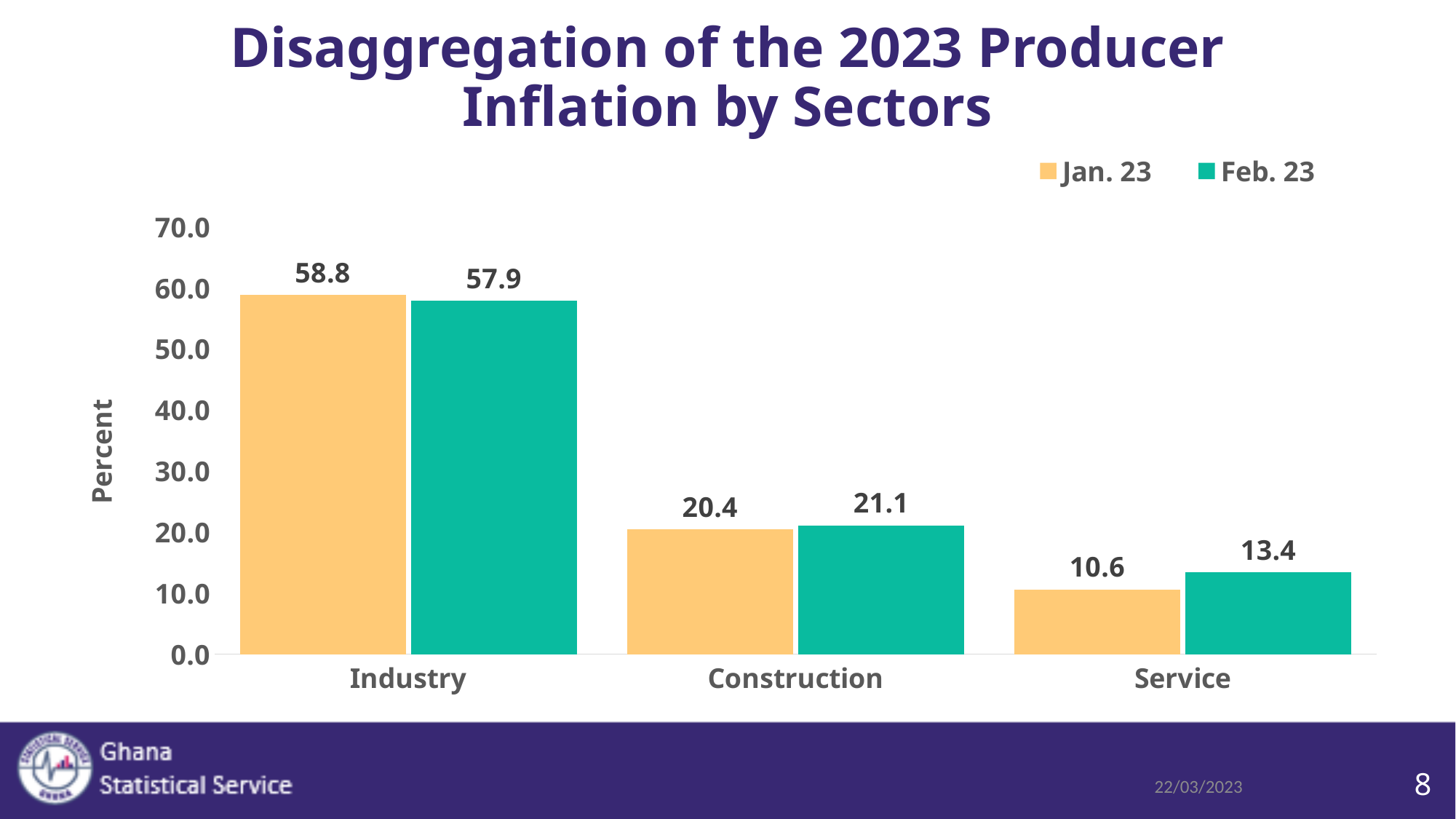
For Construction, which is larger: the Jan. 23 value or the Feb. 23 value? Feb. 23 What is the difference between the Jan. 23 and Feb. 23 values for Industry? 0.9 Which sector has the lowest Jan. 23 value? Service What is the Feb. 23 value for Service? 13.4 What is the Feb. 23 value for Construction? 21.1 What kind of chart is shown on the slide? bar chart Which sector has the highest Feb. 23 value? Industry What is the difference between the Jan. 23 and Feb. 23 values for Service? 2.8 What is the Jan. 23 value for Industry? 58.8 Is the Jan. 23 value for Construction greater or less than 30.0? less How many series does the legend list? 2 How many sectors are shown on the x axis? 3